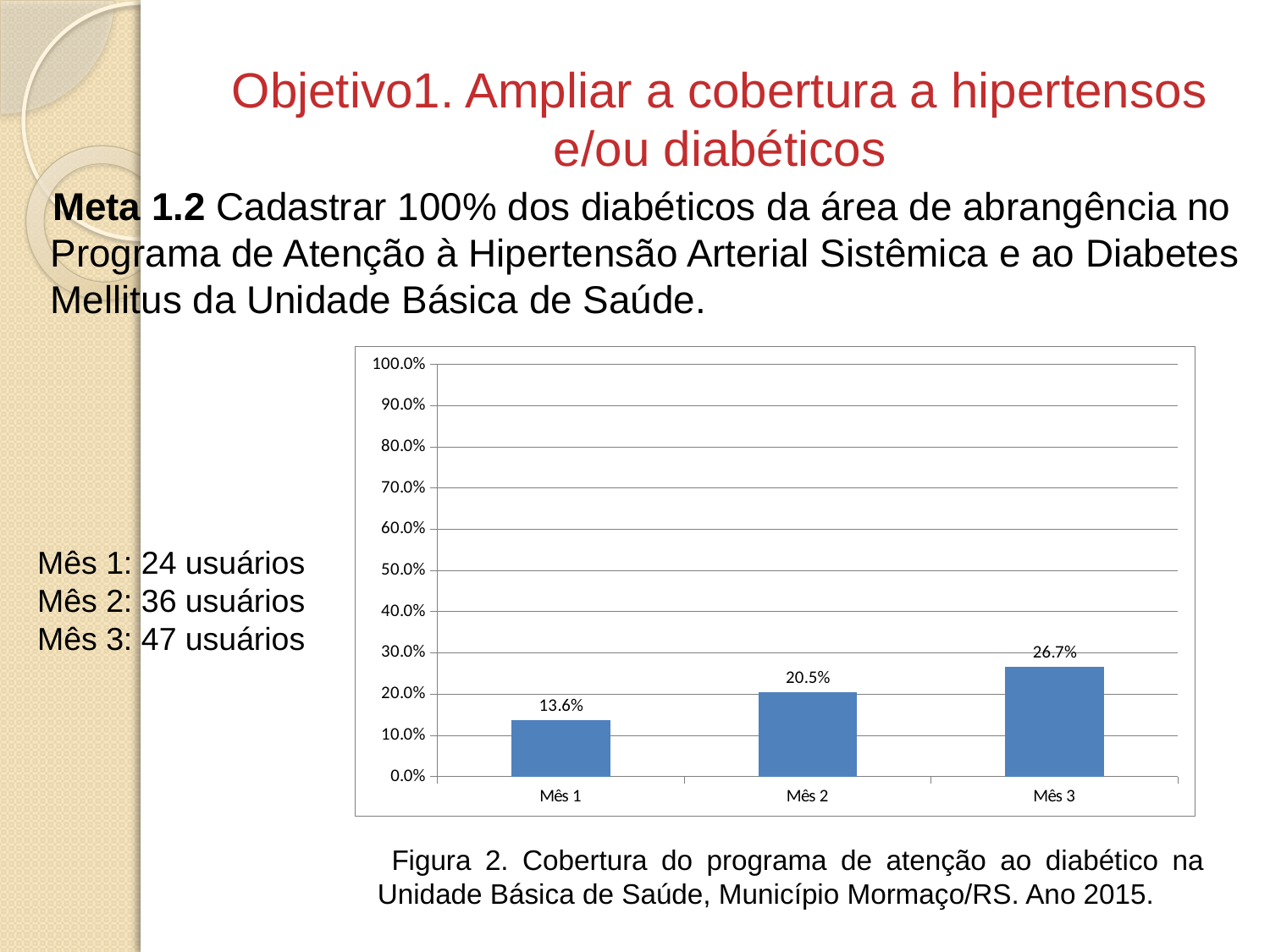
What is the value for Mês 1? 13.6% What is the value for Mês 3? 26.7% Which is larger, the value for Mês 2 or the value for Mês 3? Mês 3 Is the value for Mês 3 greater or less than 30.0%? less What is the value for Mês 2? 20.5% Which month has the highest value? Mês 3 How many months are shown on the x axis? 3 What kind of chart is shown? bar chart What is the difference between the values for Mês 2 and Mês 1? 6.9% What is the difference between the values for Mês 3 and Mês 1? 13.1% Do the values rise or fall from Mês 1 to Mês 3? rise Which month has the lowest value? Mês 1